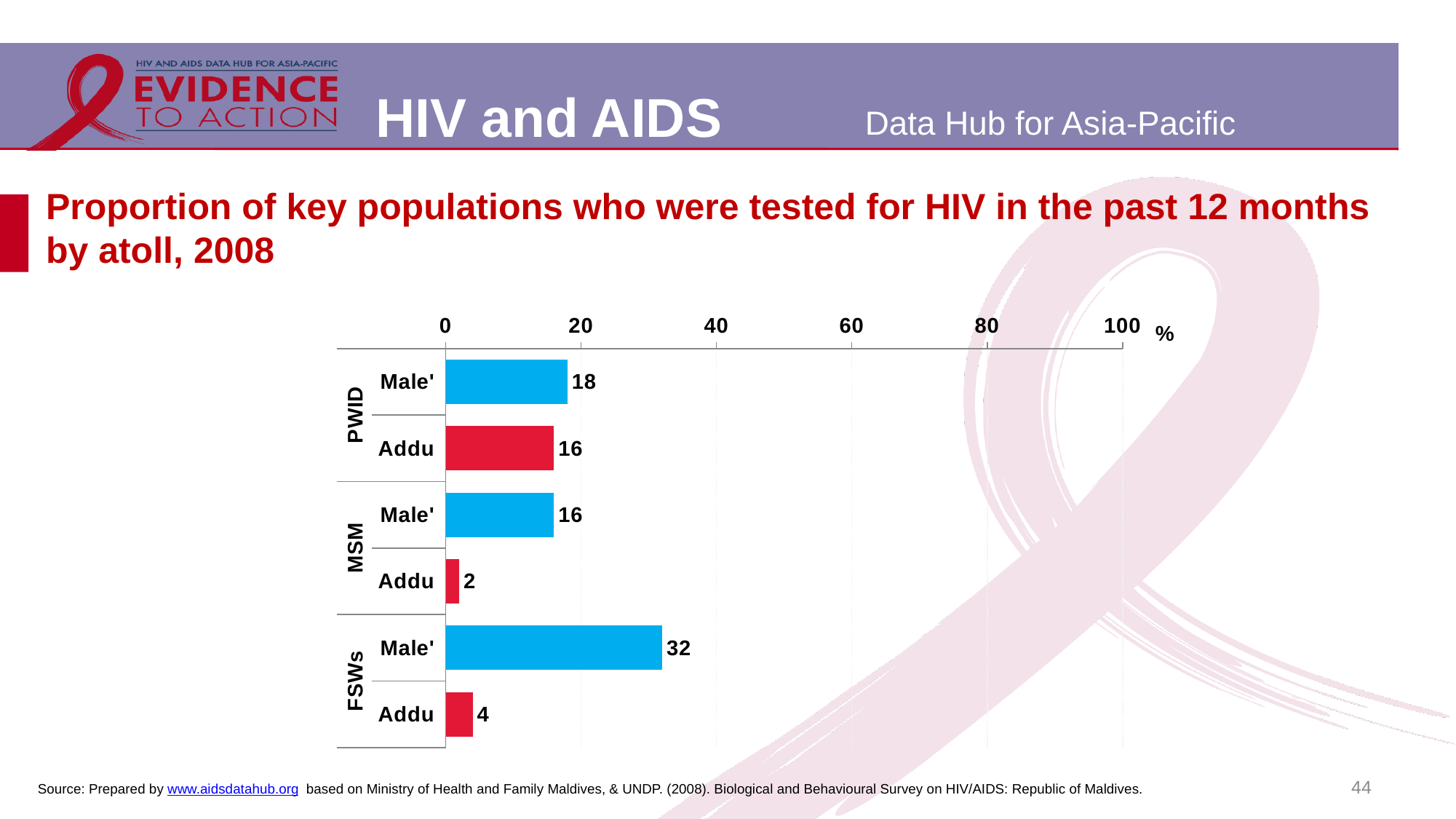
What is the value for Male' in the PWID group? 18 How many bars are plotted on the chart? 6 What type of chart is shown on the slide? Bar chart What is the value for Addu in the MSM group? 2 What is the difference between the Male' and Addu values for MSM? 14 What is the maximum value shown on the horizontal axis? 100 Which bar has the highest value on the chart? FSWs Male' What is the value for Male' in the FSWs group? 32 Which is larger: the PWID Male' value or the PWID Addu value? PWID Male' What is the difference between the Male' and Addu values for FSWs? 28 What is the value for Addu in the FSWs group? 4 Which bar has the lowest value on the chart? MSM Addu